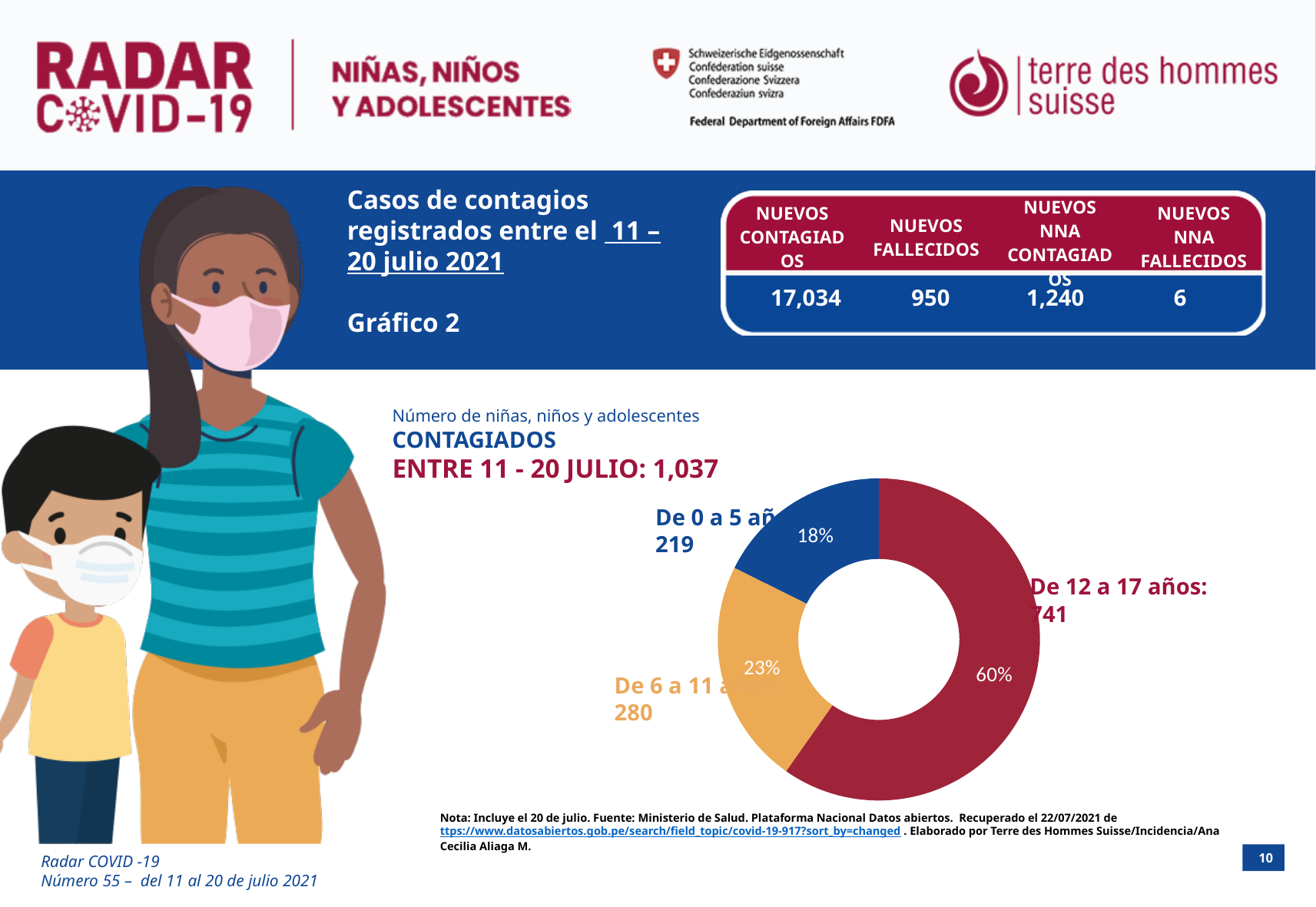
What percentage of the donut chart corresponds to the 'De 0 a 5 años' group? 18% What kind of chart is shown on the slide? Donut (pie) chart How many contagiados are shown for the 'De 12 a 17 años' group? 741 What percentage of the donut chart corresponds to the 'De 6 a 11 años' group? 23% Which age group has the smallest slice of the donut chart? De 0 a 5 años Which age group has the largest slice of the donut chart? De 12 a 17 años What is the difference in contagiados between the 'De 12 a 17 años' group and the 'De 6 a 11 años' group? 461 What total number of contagiados between 11 and 20 July is stated in the chart title? 1,037 How many age groups does the donut chart show? 3 What percentage of the donut chart corresponds to the 'De 12 a 17 años' group? 60% How many contagiados are shown for the 'De 6 a 11 años' group? 280 How many contagiados are shown for the 'De 0 a 5 años' group? 219